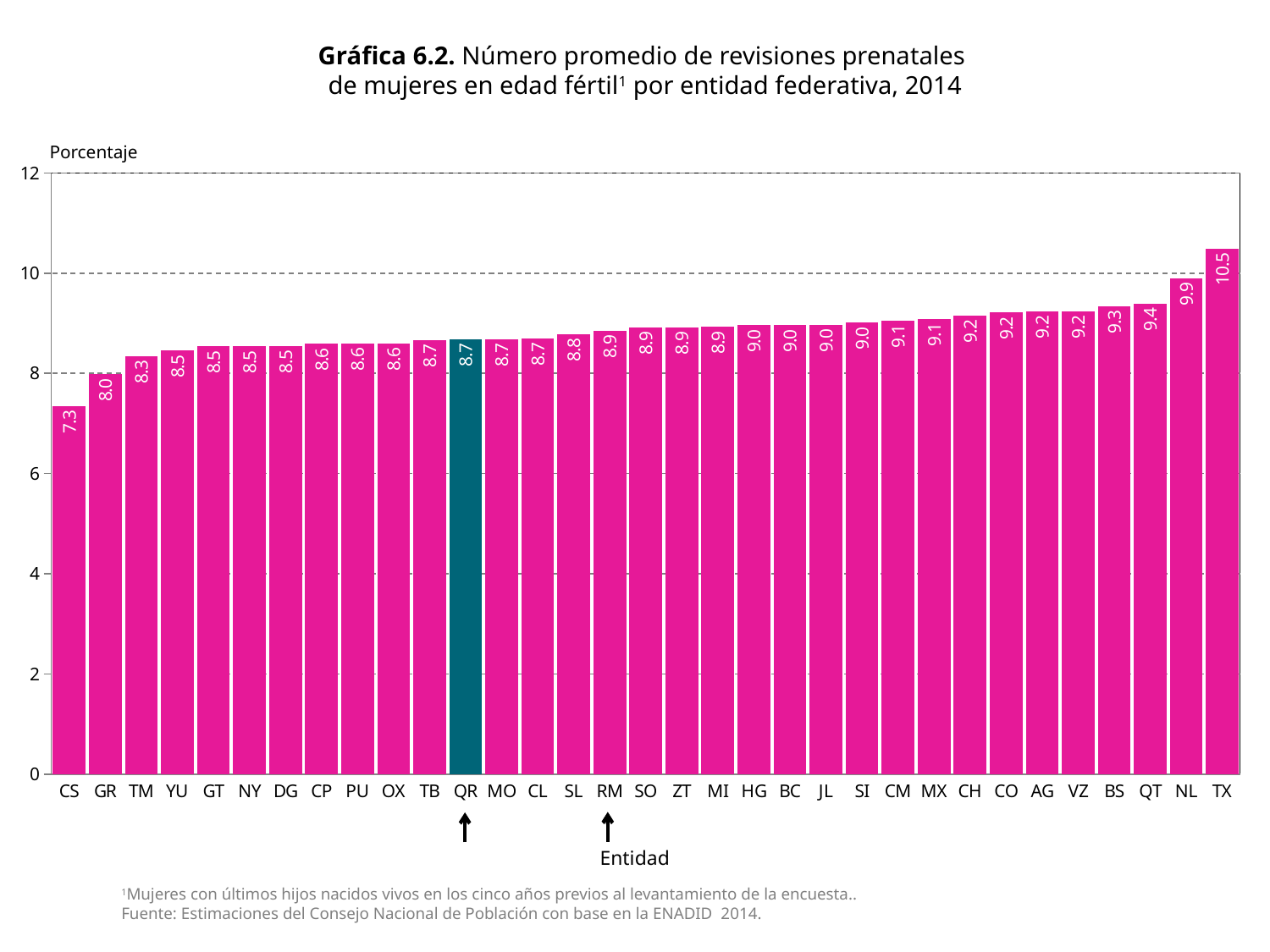
What is the value for TX? 10.5 What is the difference between the values for NL and QR? 1.2 How many bars are shown in the chart? 33 What kind of chart is this? bar chart What is the difference between the values for TX and CS? 3.2 Which entity has the lowest value? CS What is the value for QR, the bar highlighted in a different colour? 8.7 What is the value for RM? 8.9 Do the values rise or fall from left to right along the x axis? rise Which is larger, the value for GR or the value for QT? QT Which entity has the highest value? TX Is the value for NL greater or less than 10? less